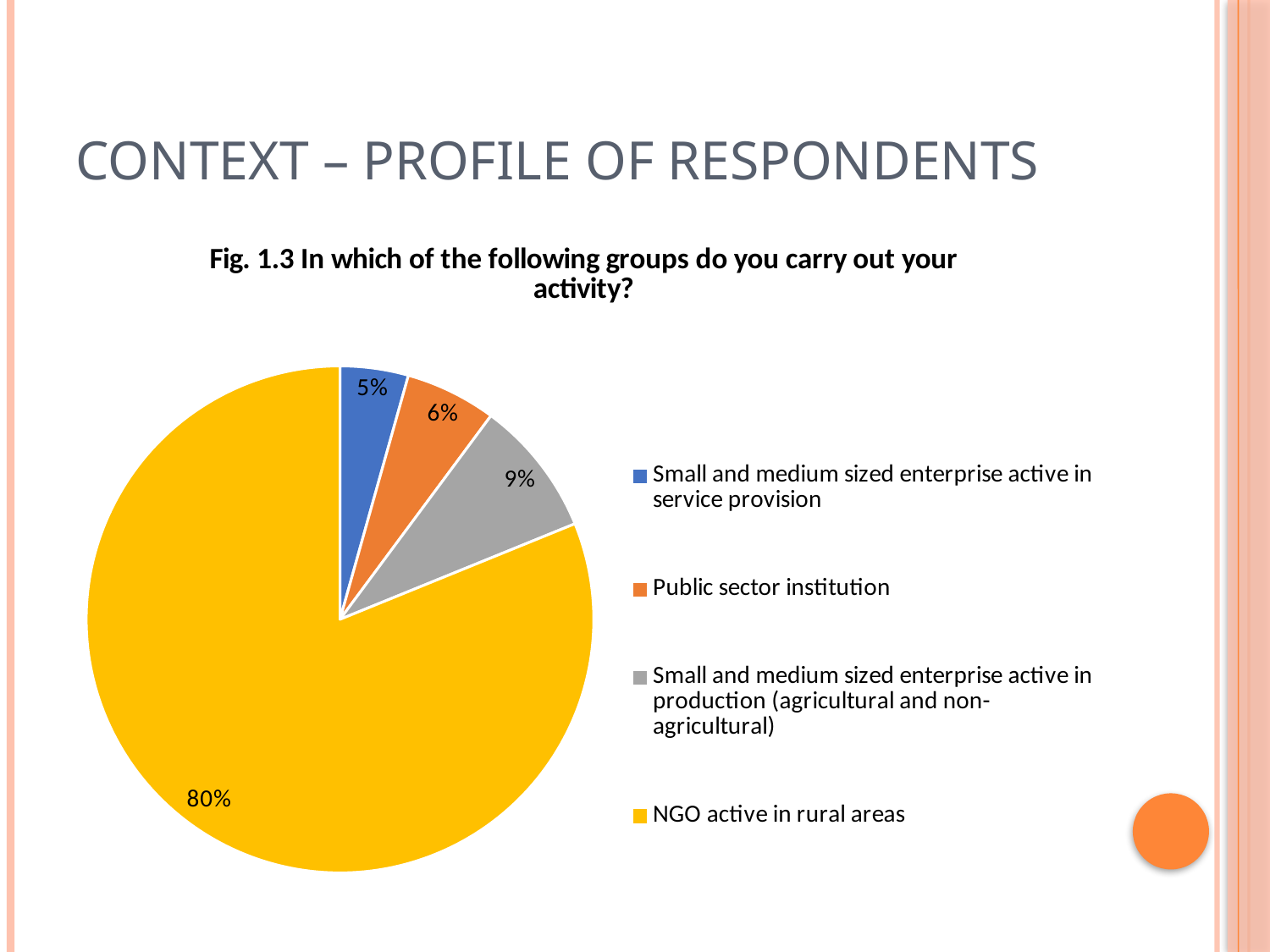
What colour is the slice for NGO active in rural areas? yellow Which is larger: the share for public sector institution or the share for small and medium sized enterprise active in production? Small and medium sized enterprise active in production What is the difference in percentage points between the NGO active in rural areas slice and the public sector institution slice? 74 What share of respondents are NGOs active in rural areas? 80% What kind of chart is shown on the slide? pie chart Which group has the smallest share of respondents? Small and medium sized enterprise active in service provision Which group has the largest share of respondents? NGO active in rural areas What share of respondents are small and medium sized enterprises active in service provision? 5% What is the title of the chart? Fig. 1.3 In which of the following groups do you carry out your activity? What share of respondents are public sector institutions? 6% What share of respondents are small and medium sized enterprises active in production (agricultural and non-agricultural)? 9% How many slices does the pie chart have? 4